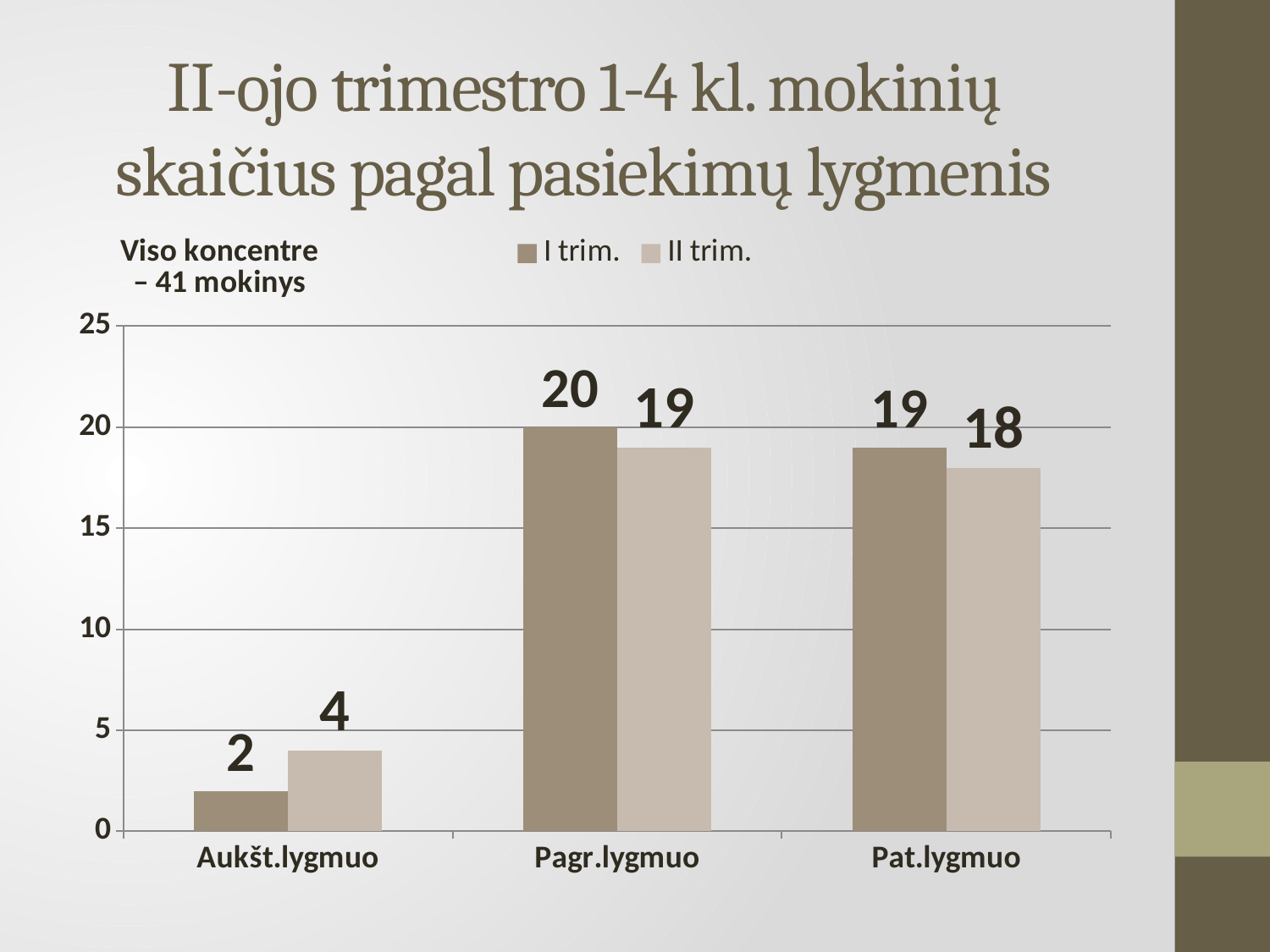
What is the value for Aukšt.lygmuo in the I trim. series? 2 How many series does the legend list? 2 What is the value for Pagr.lygmuo in the I trim. series? 20 What is the value for Pat.lygmuo in the II trim. series? 18 How many categories are shown on the x axis? 3 Which category has the highest value in the I trim. series? Pagr.lygmuo What kind of chart is shown on the slide? Bar chart What is the difference between the I trim. and II trim. values for Aukšt.lygmuo? 2 What does the text above the chart say about the total number of students? Viso koncentre – 41 mokinys What is the value for Aukšt.lygmuo in the II trim. series? 4 Which is larger for Pat.lygmuo: the I trim. value or the II trim. value? I trim. Which category has the lowest value in the II trim. series? Aukšt.lygmuo